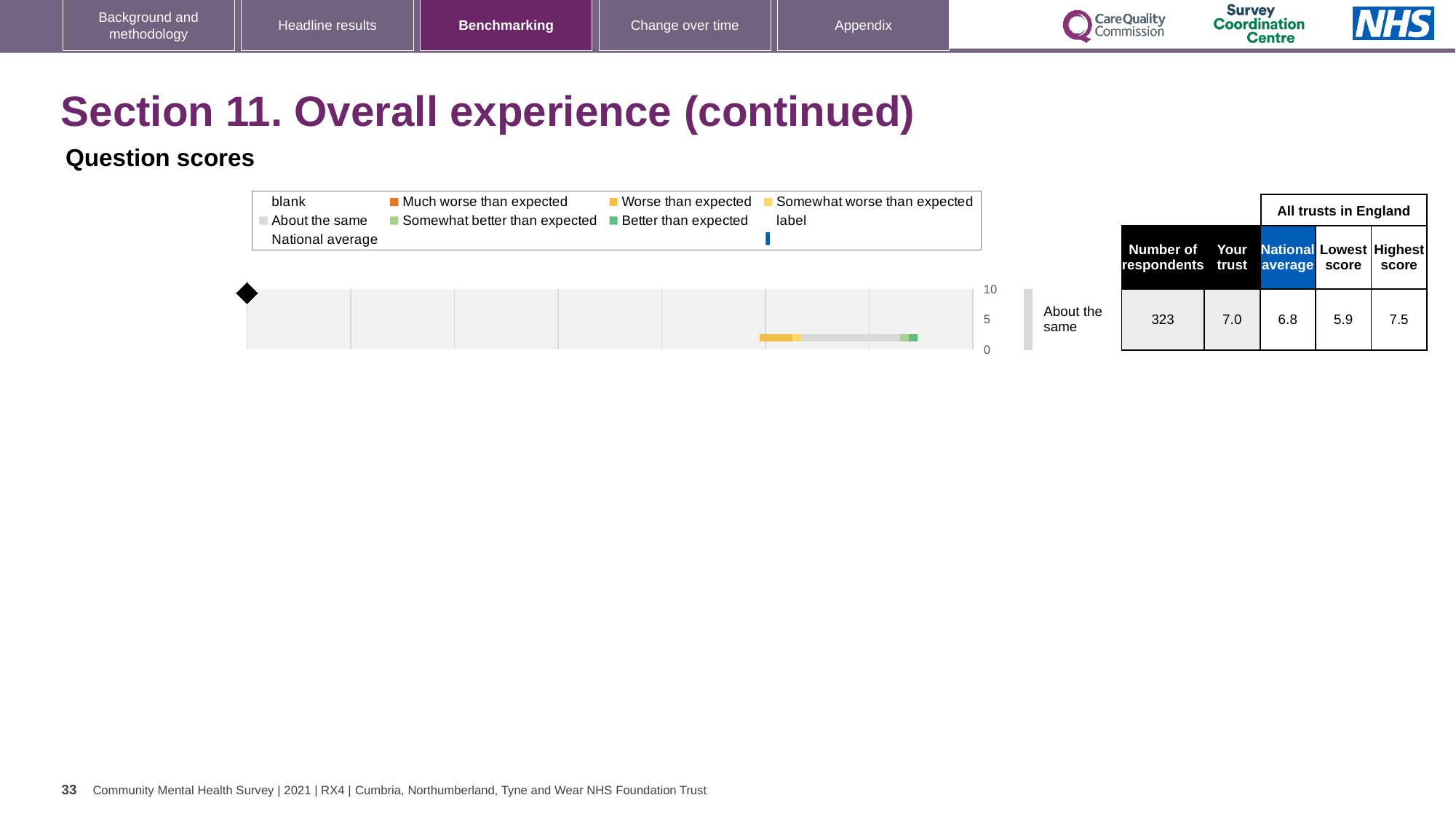
How many question categories are plotted in the chart? 1 Which is larger for this question, the 'Your trust' score or the national average? Your trust What is the difference between the 'Your trust' score and the national average? 0.2 What is the category label shown next to the bar in the chart? About the same What is the 'Your trust' score for the 'About the same' question? 7.0 How many respondents answered this question? 323 What is the national average score for the 'About the same' question? 6.8 What kind of chart is shown on the slide? bar chart What is the difference between the highest score and the lowest score for this question? 1.6 What is the highest score among all trusts in England for this question? 7.5 What is the maximum value shown on the chart's score axis? 10 What is the lowest score among all trusts in England for this question? 5.9